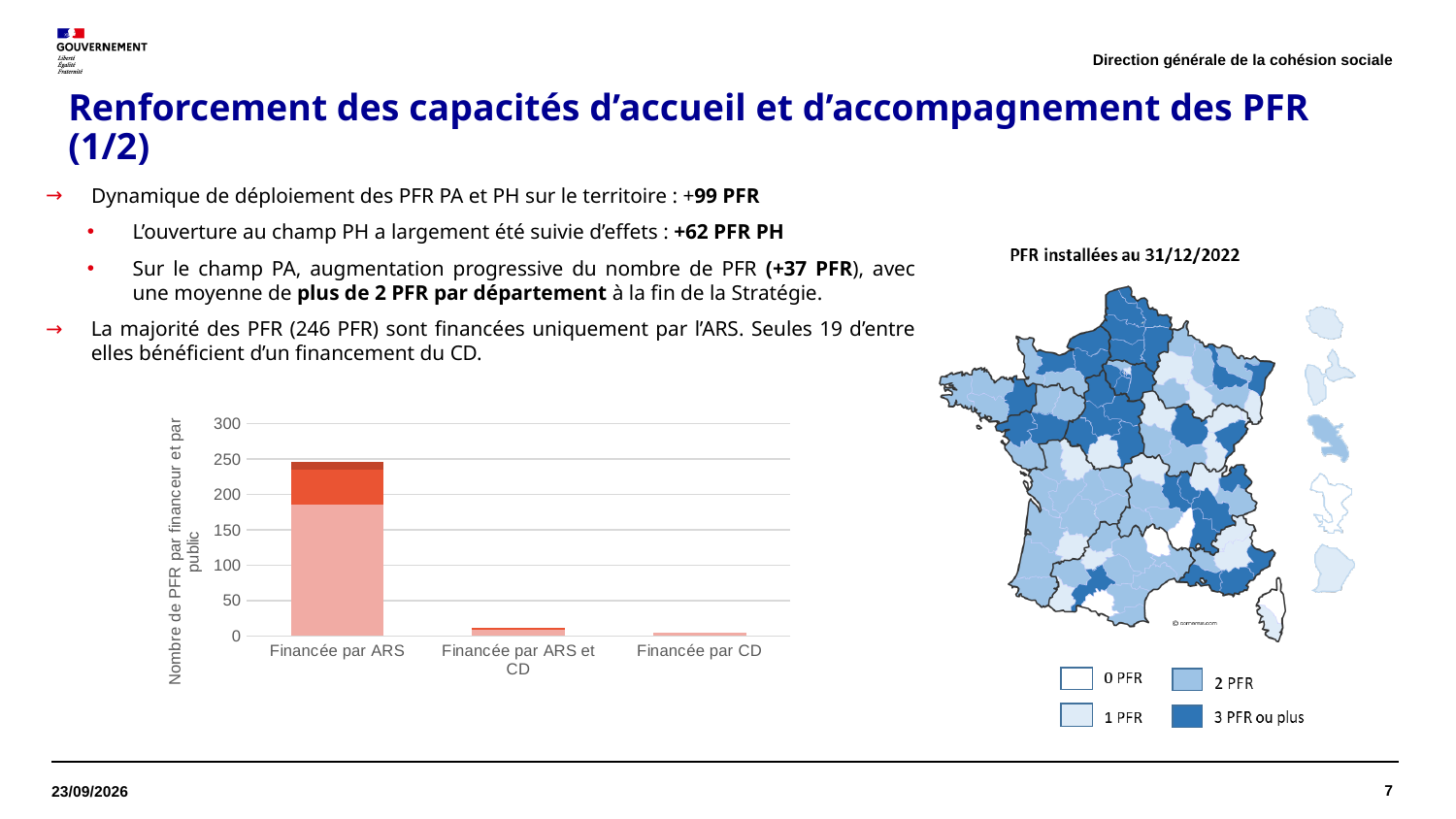
Do the values in the bar chart rise or fall from left to right along the x axis? fall What is the highest tick value shown on the y axis of the bar chart? 300 What kind of chart is shown on the left of the slide? bar chart How many categories are shown on the x axis of the bar chart? 3 Is the total value for Financée par ARS greater or less than 200? greater Which category in the bar chart has the highest value? Financée par ARS Is the value for Financée par ARS et CD greater or less than 50? less What is the title of the y axis of the bar chart? Nombre de PFR par financeur et par public Is the total value for Financée par ARS greater or less than 250? less Which is larger in the bar chart: Financée par ARS or Financée par ARS et CD? Financée par ARS Which category in the bar chart has the lowest value? Financée par CD